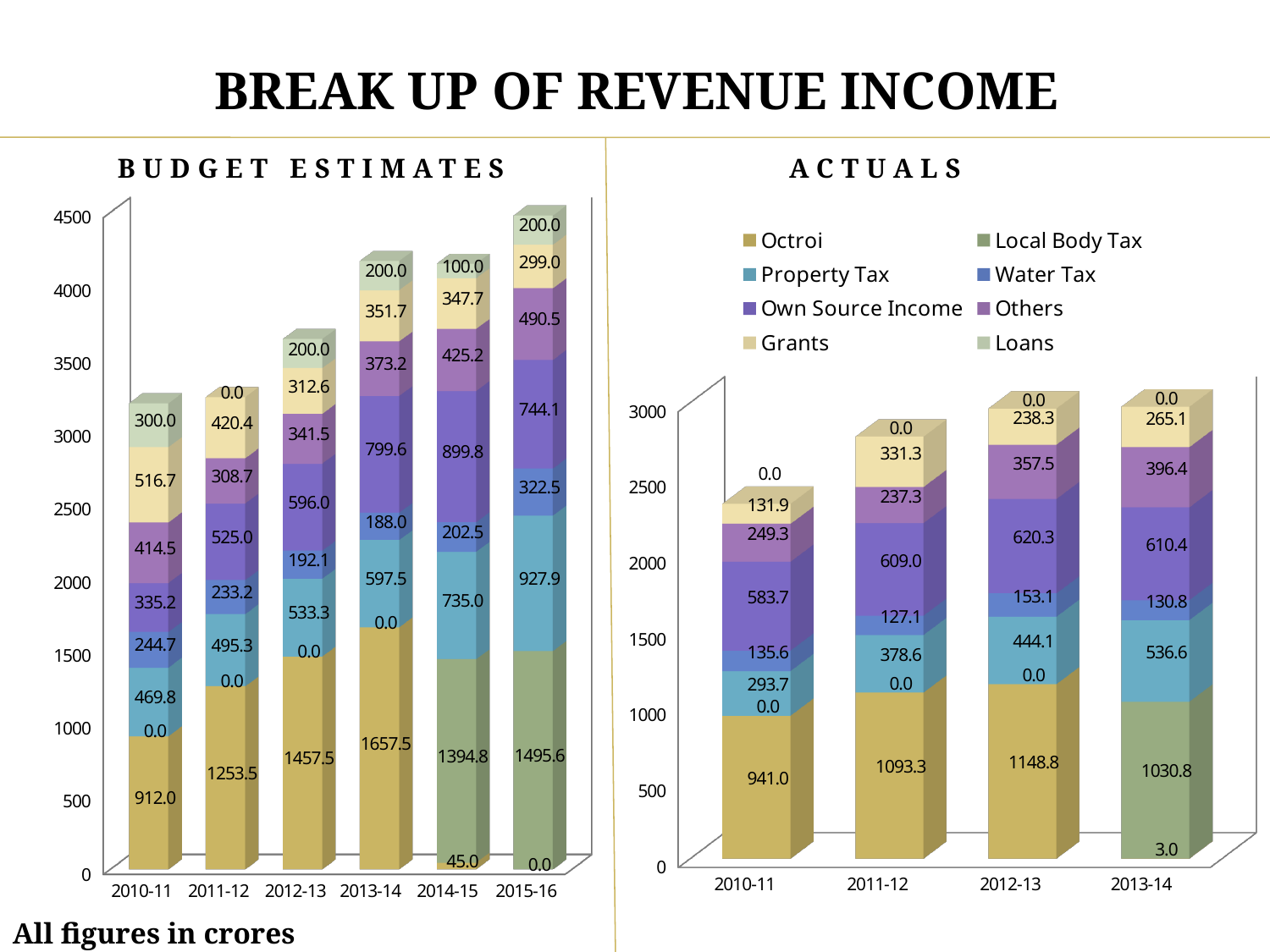
In the Budget Estimates chart, what is the Local Body Tax value for 2015-16? 1495.6 In the Actuals chart, what is the total of the stacked bar for 2010-11? 2335.2 How many years are shown on the x axis of the Budget Estimates chart? 6 In the Budget Estimates chart, what is the Octroi value for 2012-13? 1457.5 In the Actuals chart, is the Others value larger in 2012-13 or 2013-14? 2013-14 In the Budget Estimates chart, what is the difference between the Own Source Income values for 2014-15 and 2013-14? 100.2 How many series does the legend on the Actuals chart list? 8 In the Actuals chart, what is the Own Source Income value for 2011-12? 609.0 What kind of chart is the Actuals chart? Stacked bar chart In the Budget Estimates chart, what is the Grants value for 2010-11? 516.7 In the Actuals chart, which year has the highest Octroi value? 2012-13 In the Actuals chart, what is the Property Tax value for 2013-14? 536.6